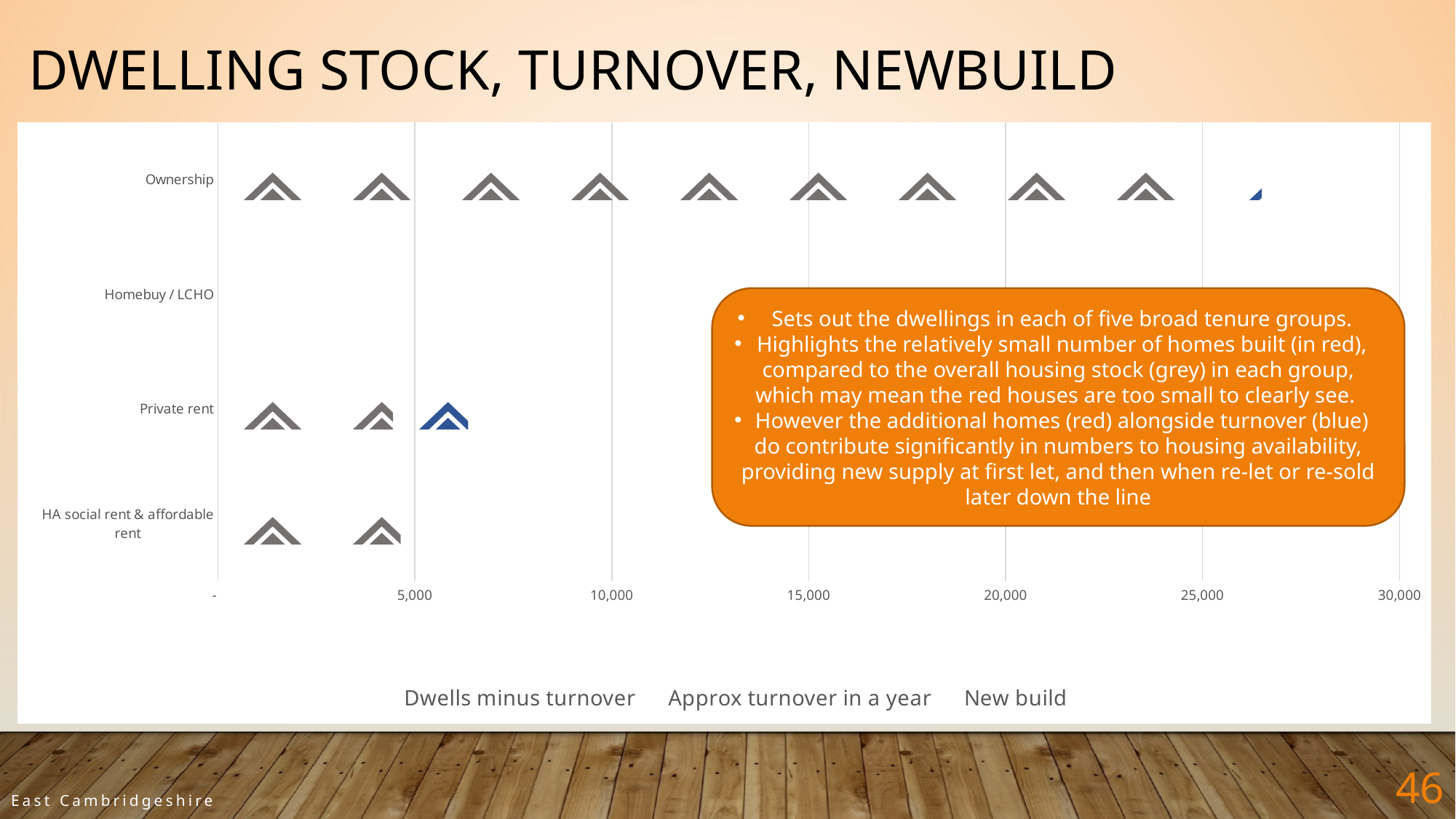
Which tenure group shows the lowest (essentially no visible) dwelling stock in the chart? Homebuy / LCHO Is the total value for Private rent greater or less than 5,000? greater What are the three series named in the chart legend? Dwells minus turnover, Approx turnover in a year, New build What is the title of the chart slide? DWELLING STOCK, TURNOVER, NEWBUILD Is the total value for Private rent greater or less than 10,000? less How many series does the chart legend list? 3 Which has the larger total dwelling stock, Ownership or Private rent? Ownership Which tenure group has the highest total dwelling stock in the chart? Ownership Is the total value for Ownership greater or less than 25,000? greater What kind of chart is shown on the slide? bar chart What is the maximum value shown on the horizontal axis of the chart? 30,000